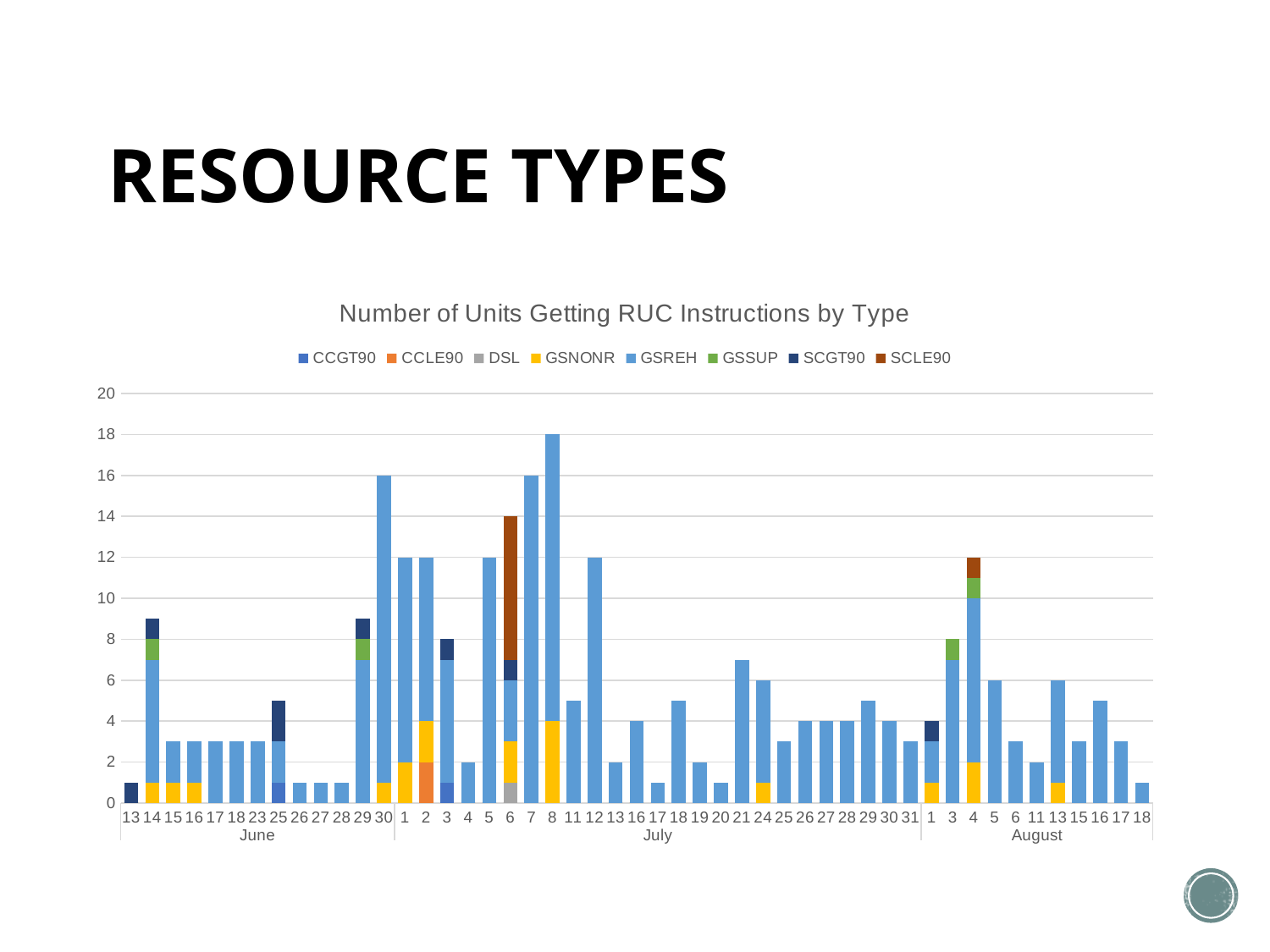
What is the total number of units on July 8? 18 Which has a larger total, July 6 or July 7? July 7 Is the total for July 21 greater or less than 6? greater What kind of chart is shown on the slide? Stacked bar chart How many months are grouped along the x axis? 3 How many August dates are shown on the x axis? 11 How many series does the legend list? 8 What is the total number of units on June 30? 16 Which date has the highest total number of units getting RUC instructions? July 8 What is the difference between the totals for July 8 and June 30? 2 What is the title of the chart? Number of Units Getting RUC Instructions by Type Is the total for June 25 greater or less than 4? greater